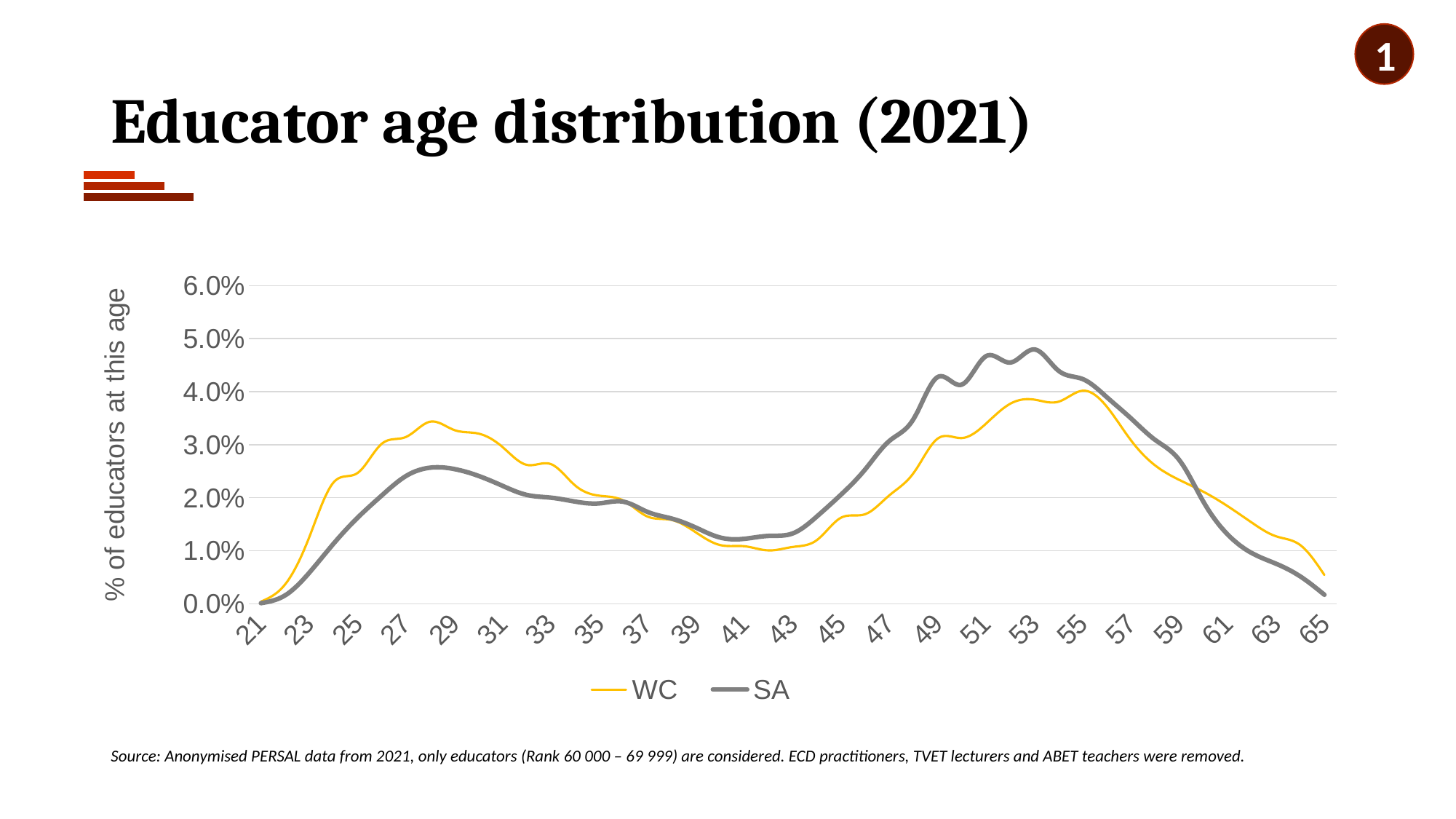
Which series reaches the highest peak on the chart? SA At age 25, which series has the higher value, WC or SA? WC What is the label on the vertical axis? % of educators at this age Is the SA value at age 65 greater or less than 1.0%? less Is the SA value at age 41 greater or less than 2.0%? less At age 53, which series has the higher value, WC or SA? SA How many series does the legend list? 2 Is the SA value at age 53 greater or less than 4.0%? greater Does the SA line rise or fall between age 43 and age 53? Rise What are the two series named in the legend? WC and SA What kind of chart is shown on the slide? Line chart